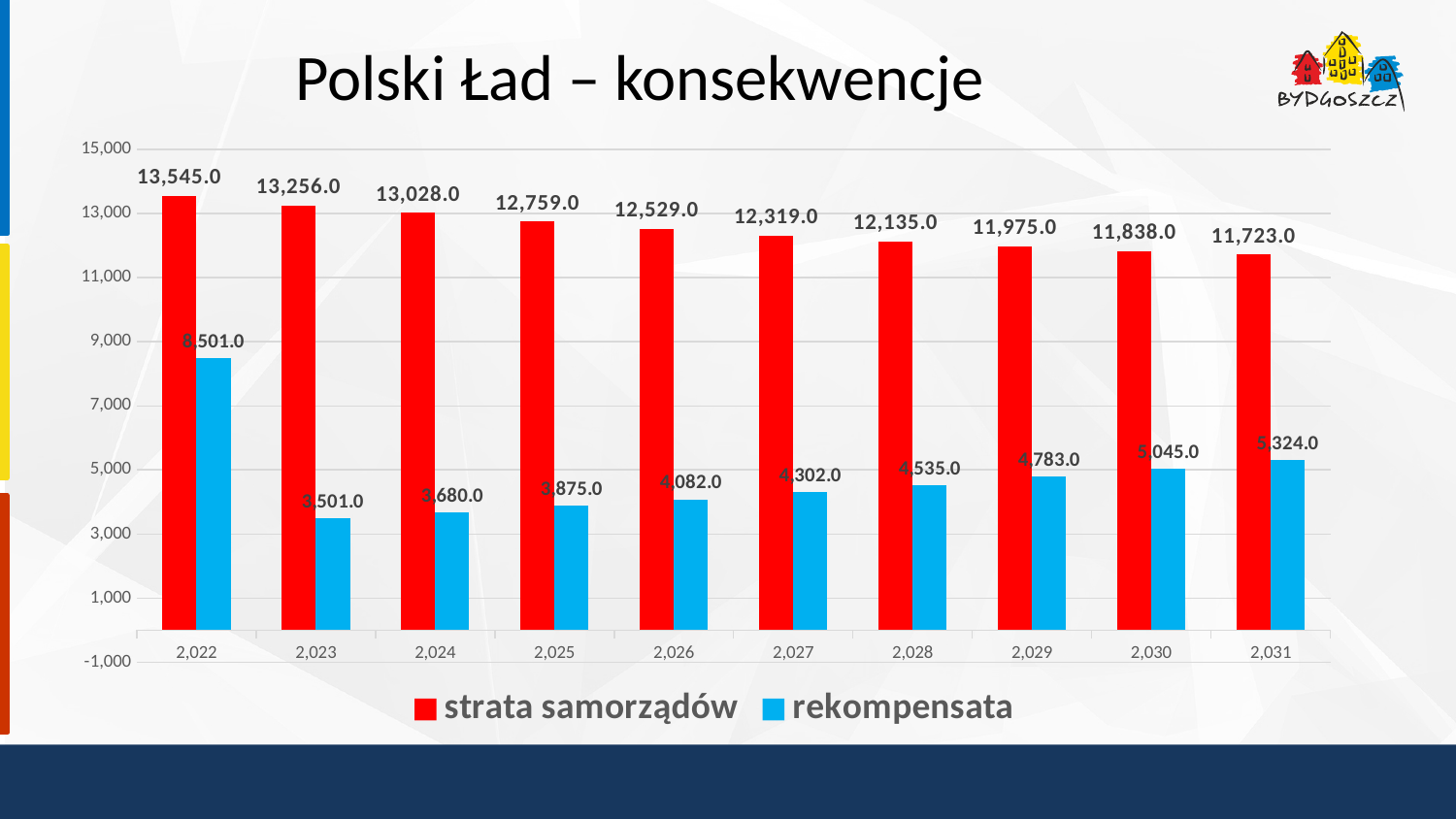
What is the value of 'rekompensata' for 2,023? 3,501.0 What is the value of 'strata samorządów' for 2,022? 13,545.0 In which year is 'rekompensata' highest? 2,022 How many year categories are shown on the x axis? 10 What type of chart is shown on the slide? bar chart Does 'strata samorządów' rise or fall from 2,022 to 2,031? fall What is the value of 'rekompensata' for 2,031? 5,324.0 What is the difference between 'strata samorządów' and 'rekompensata' in 2,022? 5,044.0 How many series does the legend list? 2 Which colour represents 'rekompensata' in the chart? blue In which year is 'strata samorządów' lowest? 2,031 Which is larger in 2,031: 'strata samorządów' or 'rekompensata'? strata samorządów